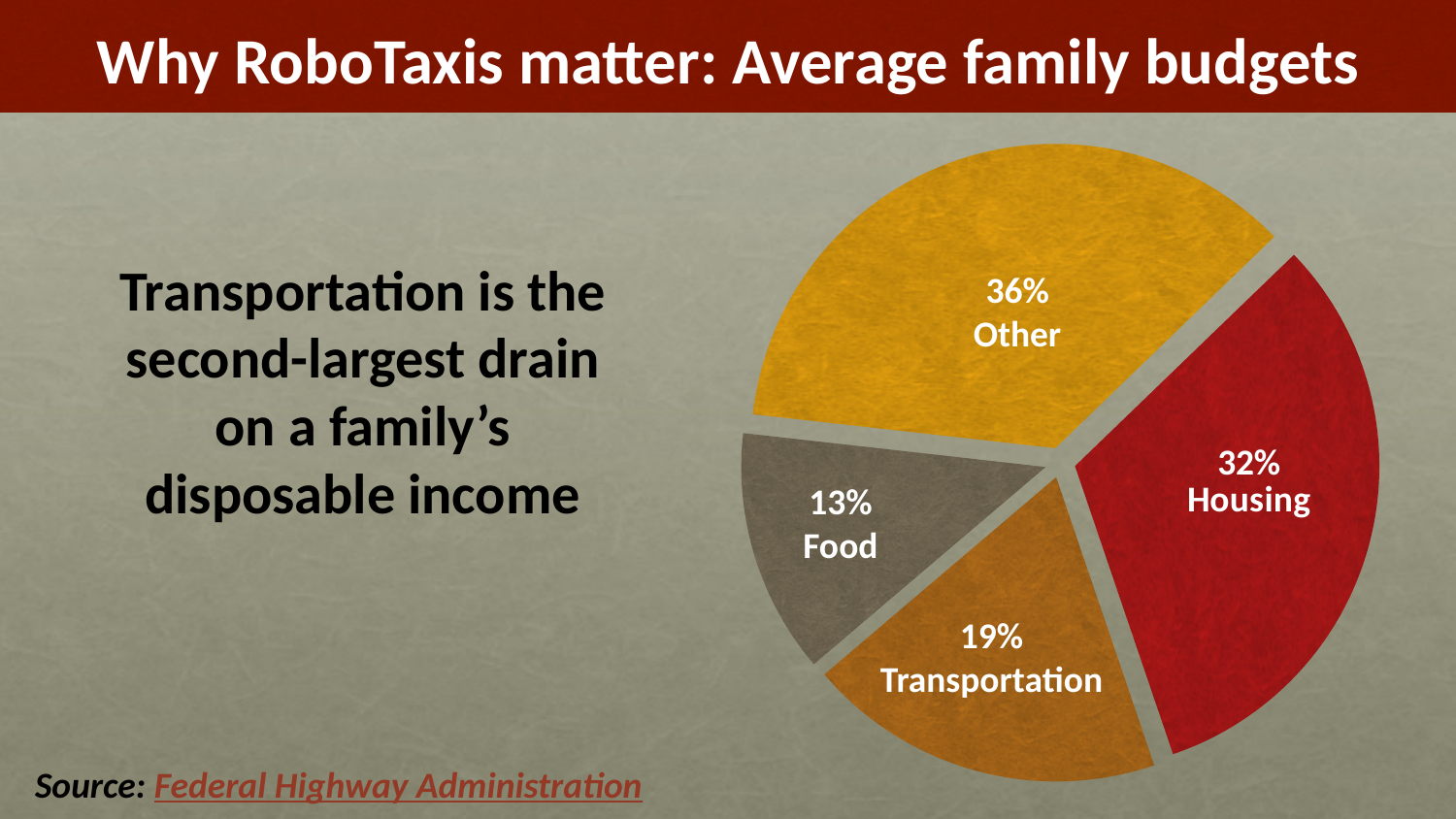
What share of the family budget goes to Transportation? 19% What share of the family budget is labelled Other? 36% What colour is the Housing slice? red Which category has the largest slice of the pie? Other Which is larger, the Housing slice or the Transportation slice? Housing What share of the family budget goes to Food? 13% How many slices does the pie chart have? 4 Which category has the smallest slice of the pie? Food What is the difference in percentage points between the Housing and Transportation slices? 13 What is the difference in percentage points between the Transportation and Food slices? 6 What kind of chart is shown on the slide? pie chart What share of the family budget goes to Housing? 32%